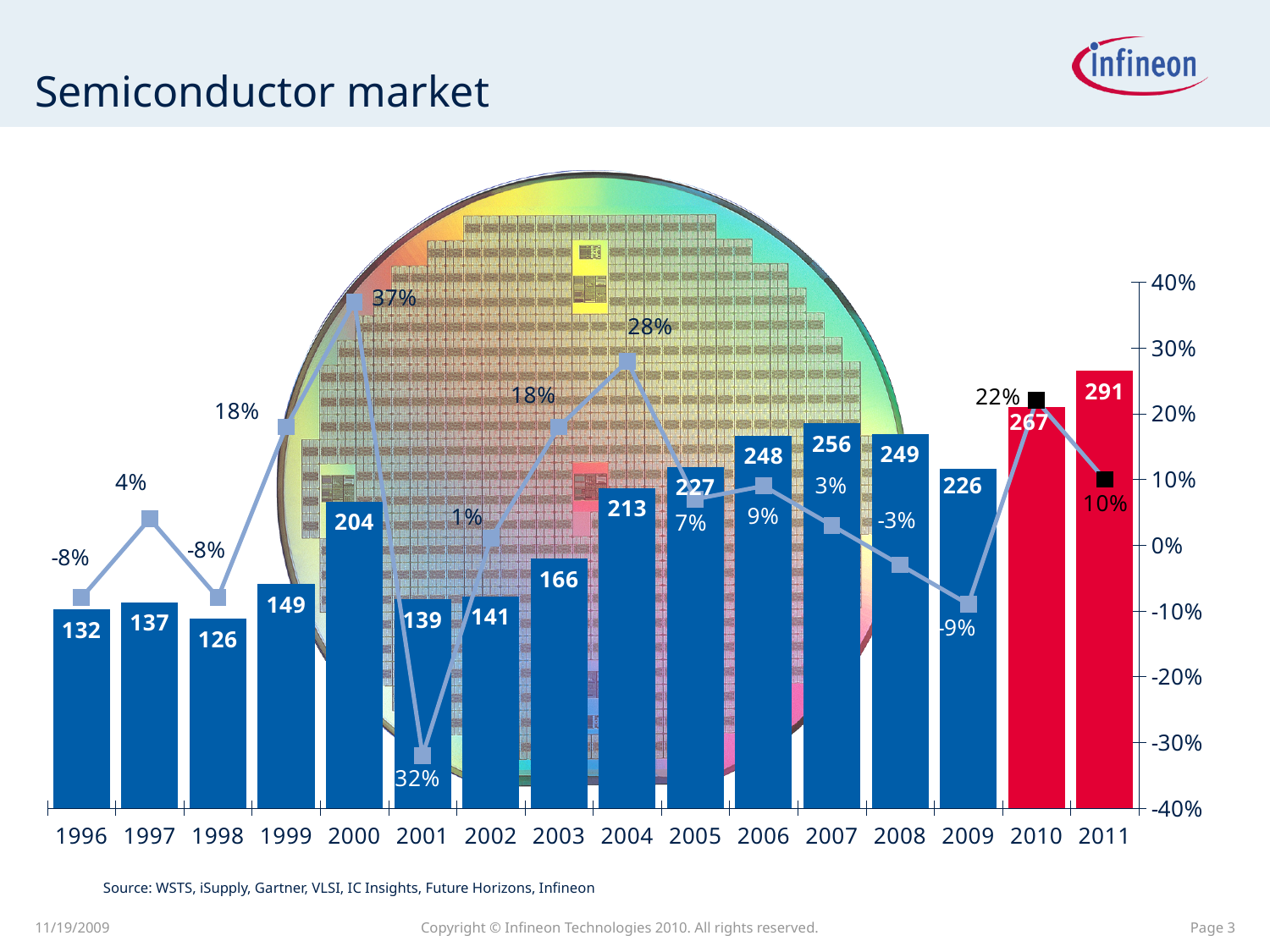
What is the bar value for 2000? 204 What is the highest growth percentage shown on the line? 37% What growth percentage is shown on the line for 2004? 28% What is the bar value for 2007? 256 Which bar value is larger, 2008 or 2009? 2008 Do the bar values rise or fall from 2001 to 2007? rise Which year has the highest bar value? 2011 What growth percentage is shown on the line for 2010? 22% What is the title of the slide? Semiconductor market Which year has the lowest bar value? 1998 What is the difference between the bar values for 2011 and 2010? 24 How many years are shown on the x axis? 16